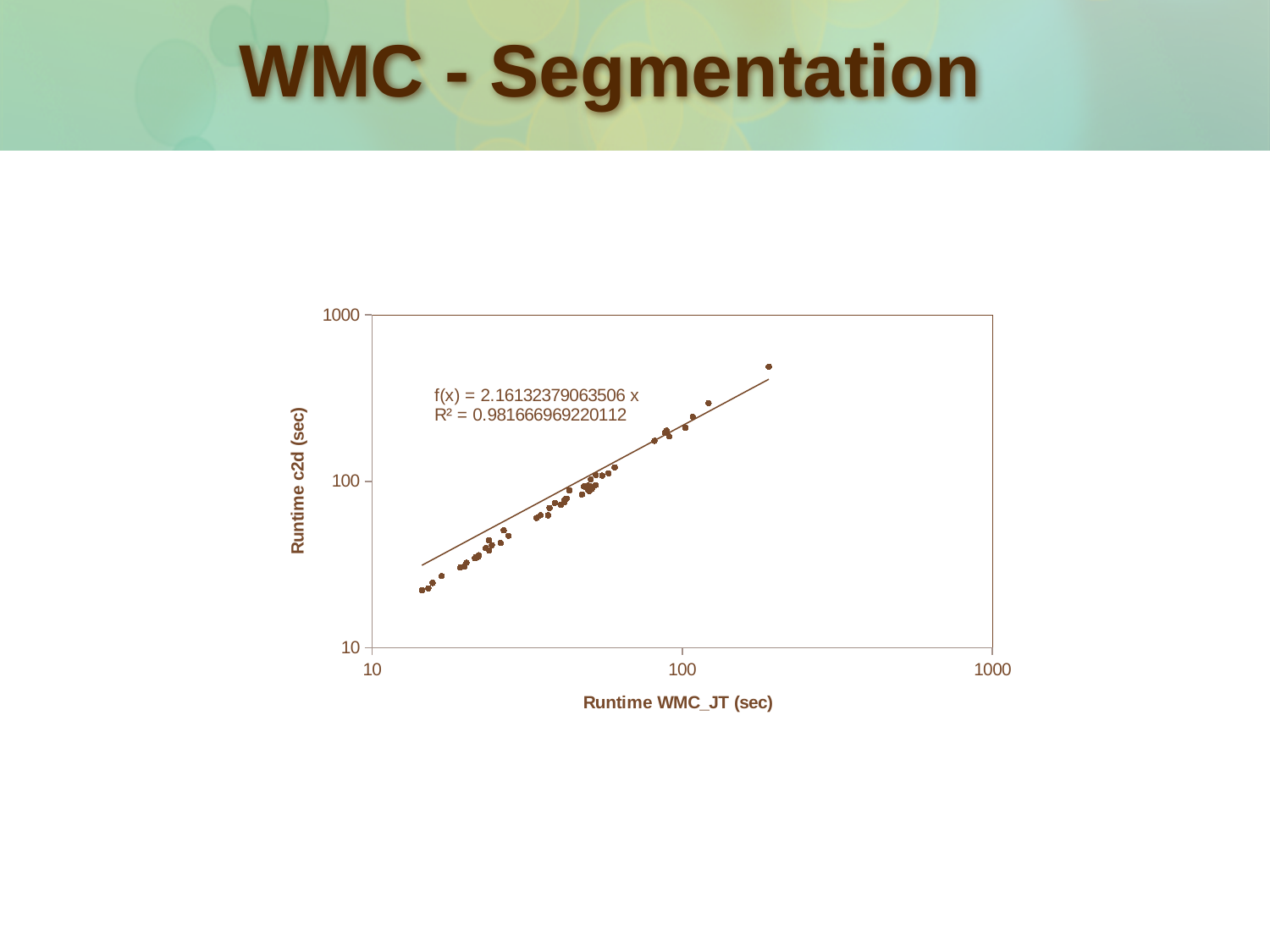
What is the trendline equation printed on the chart? f(x) = 2.16132379063506 x Is the Runtime WMC_JT of the rightmost plotted point greater or less than 100? greater Do the plotted points rise or fall as Runtime WMC_JT increases? rise Is the Runtime WMC_JT of the leftmost plotted point greater or less than 100? less Is the Runtime c2d of the highest plotted point greater or less than 100? greater What R² value is printed on the chart? R² = 0.981666969220112 What is the label of the y axis of the chart? Runtime c2d (sec) What is the label of the x axis of the chart? Runtime WMC_JT (sec) What kind of chart is shown on the slide? scatter chart